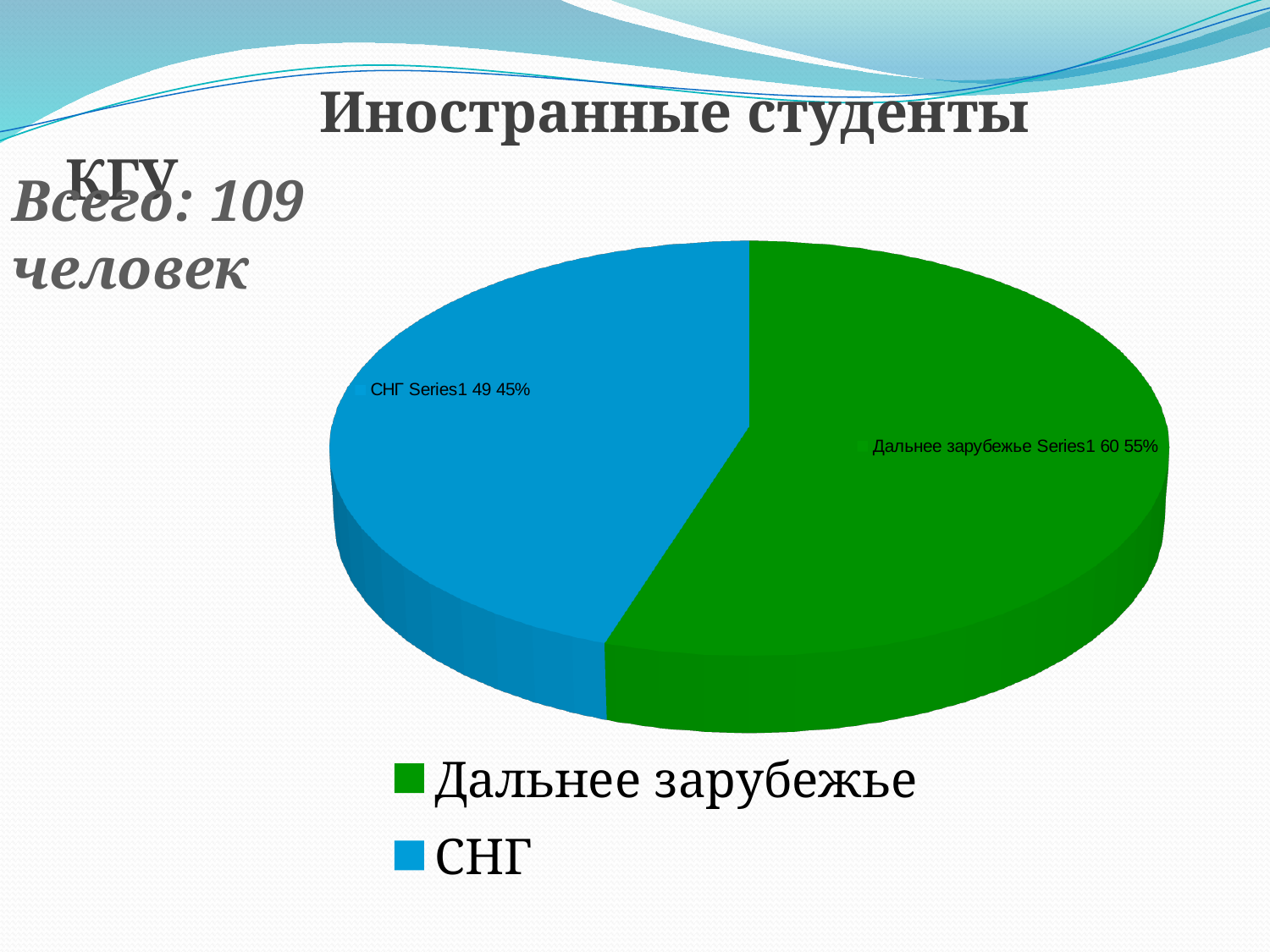
Which is larger, the value for Дальнее зарубежье or the value for СНГ? Дальнее зарубежье What is the value for Дальнее зарубежье? 60 What percentage share does Дальнее зарубежье have? 55% Which category has the smallest slice? СНГ What kind of chart is shown on the slide? pie chart What is the total of the two slice values? 109 What colour is the slice for СНГ? blue What percentage share does СНГ have? 45% Which category has the largest slice? Дальнее зарубежье What is the value for СНГ? 49 What is the difference between the values for Дальнее зарубежье and СНГ? 11 How many slices does the pie chart have? 2